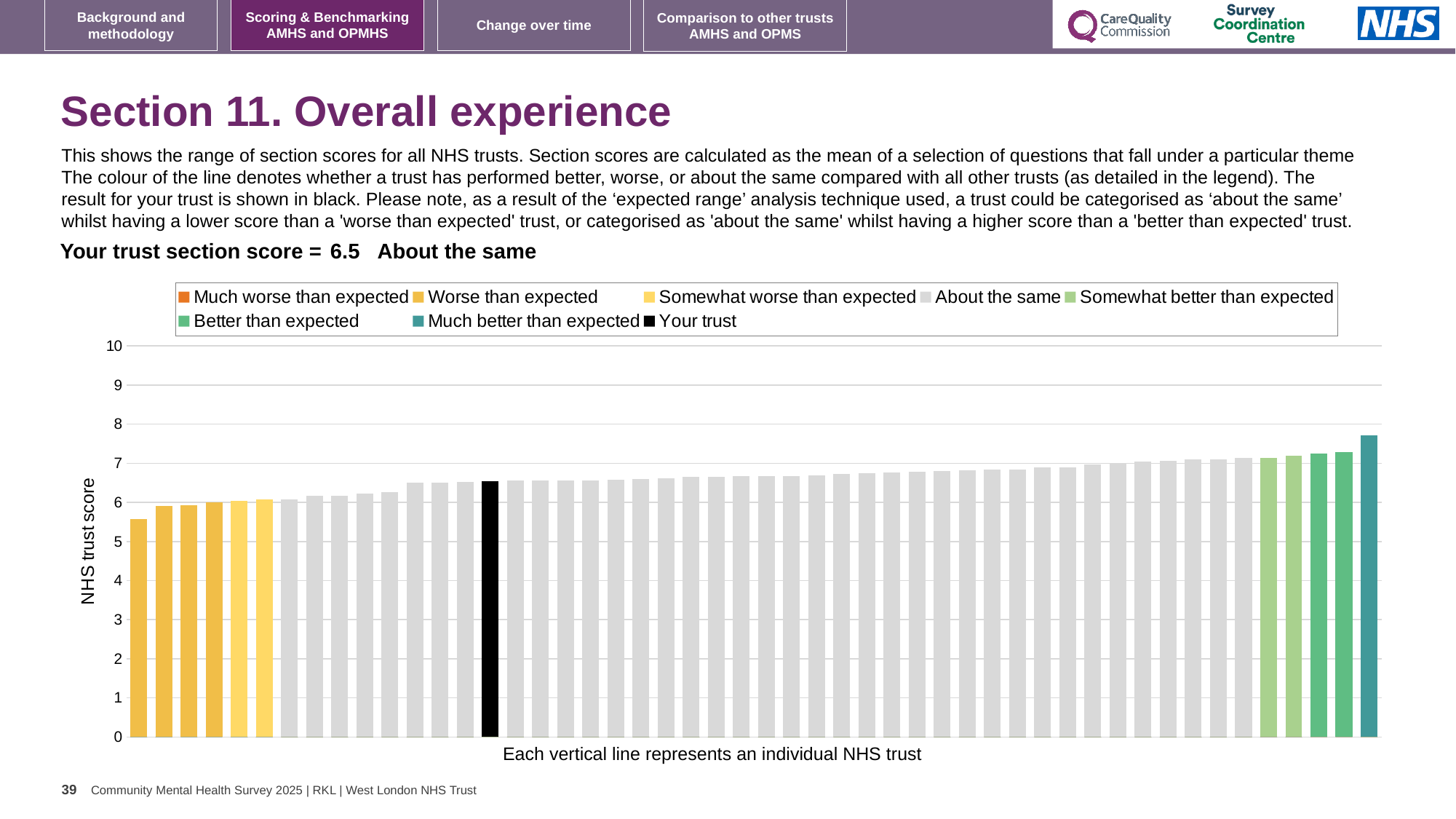
How many trusts are coloured as 'Much better than expected' in the chart? 1 How many entries does the chart legend list? 8 Is the value of the highest bar (rightmost trust) greater or less than 7? greater What kind of chart is shown on the slide? bar chart Is the value of the lowest bar (leftmost trust) greater or less than 6? less Is the value for your trust (the black bar) greater or less than 6? greater Which category does your trust fall into according to the slide? About the same What is the section score for your trust shown on the slide? 6.5 Which is larger: the score of your trust (black bar) or the score of the rightmost teal bar? the rightmost teal bar What is the label on the vertical axis of the chart? NHS trust score What colour is used for 'Your trust' in the chart legend? black Do the bar values rise or fall from left to right along the x axis? rise